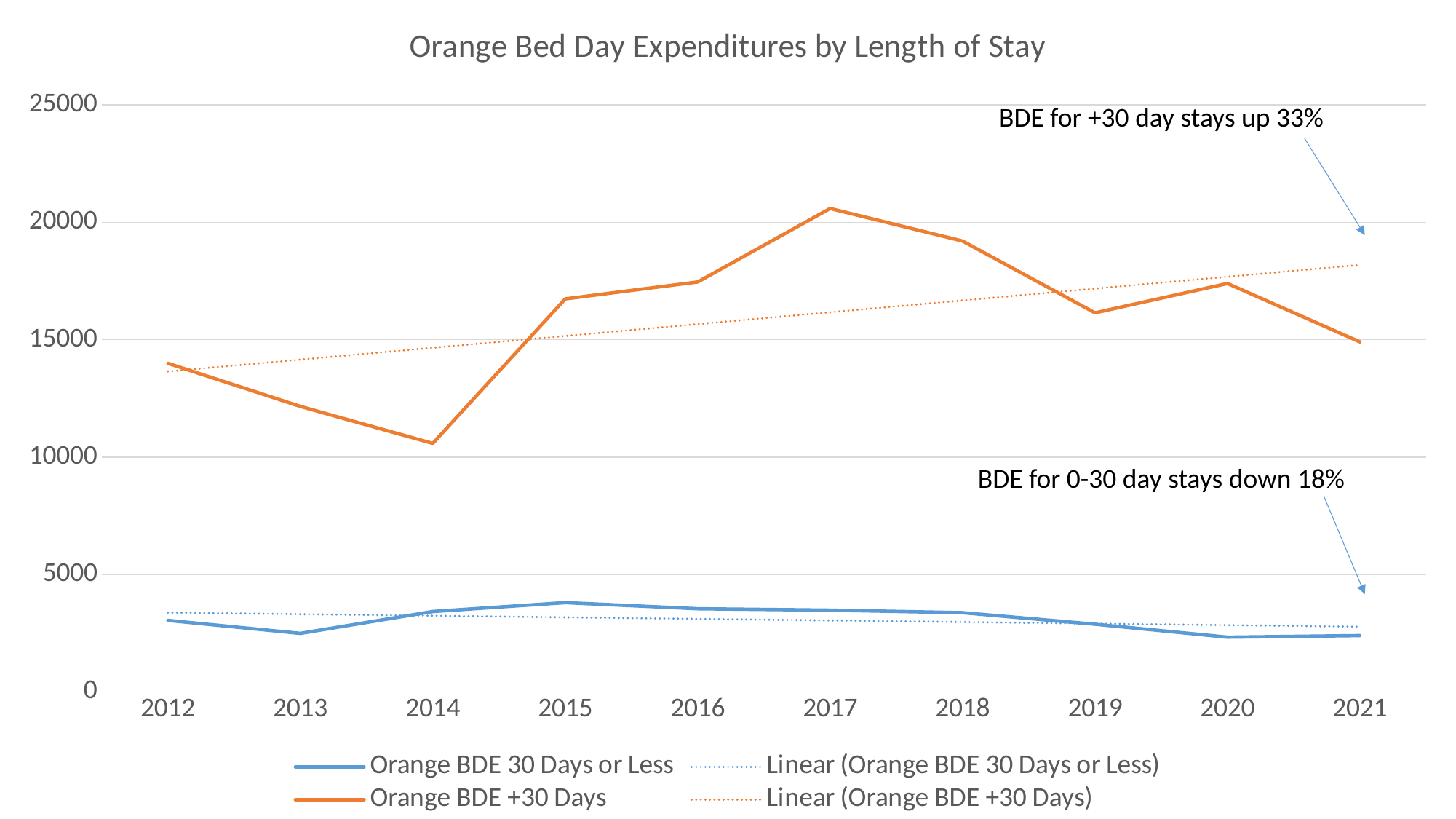
How many series does the legend list? 4 Is the value for Orange BDE 30 Days or Less in 2015 greater or less than 5000? less In which year is Orange BDE +30 Days lowest? 2014 Is the value for Orange BDE +30 Days in 2017 greater or less than 20000? greater What type of chart is shown on the slide? Line chart Which is larger for Orange BDE +30 Days: the value in 2012 or the value in 2013? 2012 How many years are shown on the x axis? 10 In which year is Orange BDE +30 Days highest? 2017 Is the value for Orange BDE +30 Days in 2014 greater or less than 15000? less Does the linear trendline for Orange BDE 30 Days or Less rise or fall from 2012 to 2021? Fall What is the title of the chart? Orange Bed Day Expenditures by Length of Stay In which year is Orange BDE 30 Days or Less highest? 2015